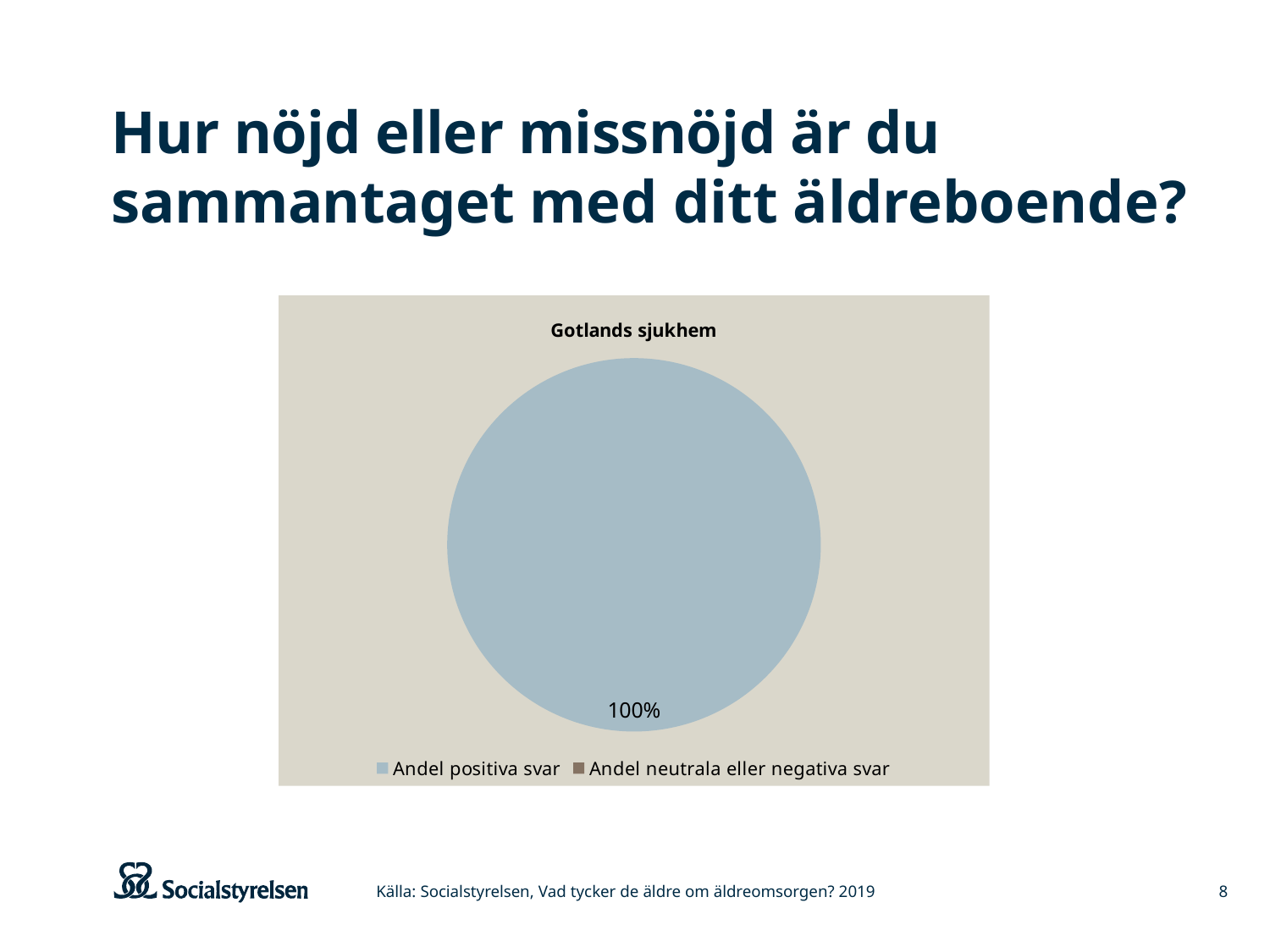
What is the only percentage value printed on the chart? 100% Which is larger, the share for Andel positiva svar or the share for Andel neutrala eller negativa svar? Andel positiva svar What share of the pie is labelled for Andel positiva svar? 100% How many visible slices does the pie chart have? 1 What kind of chart is shown on the slide? pie chart Which category makes up the largest share of the pie? Andel positiva svar How many entries does the legend list? 2 What is the title of the chart? Gotlands sjukhem Which legend entry is shown in the light blue colour? Andel positiva svar